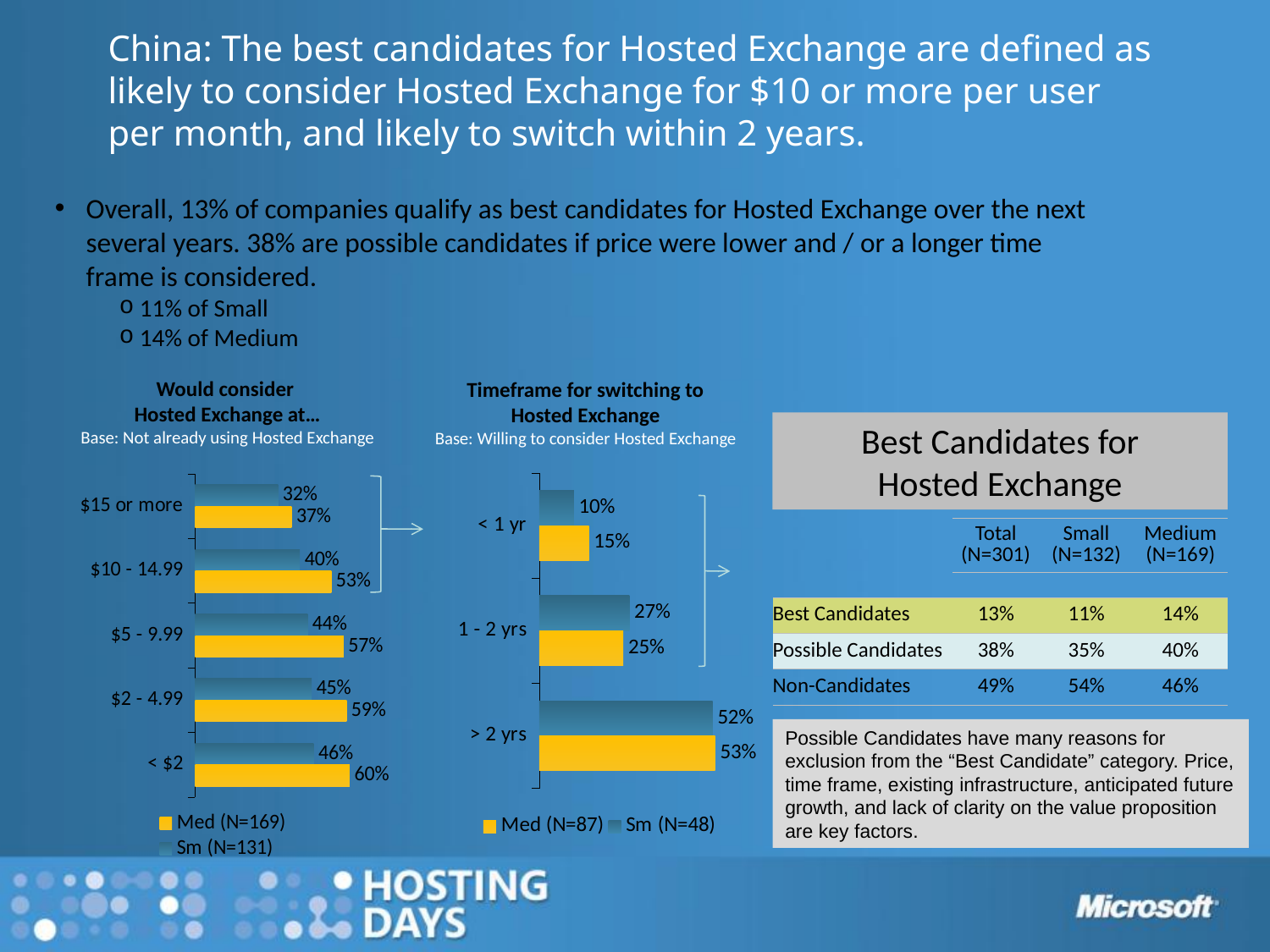
In the "Would consider Hosted Exchange at..." chart, what is the value for Sm at $15 or more? 32% In the "Would consider Hosted Exchange at..." chart, what is the value for Med at $10 - 14.99? 53% In the "Timeframe for switching to Hosted Exchange" chart, which is larger at 1 - 2 yrs: the Sm value or the Med value? Sm In the "Would consider Hosted Exchange at..." chart, which price category has the highest Med value? < $2 In the "Timeframe for switching to Hosted Exchange" chart, what is the value for Sm at > 2 yrs? 52% How many series does the legend of the "Timeframe for switching to Hosted Exchange" chart list? 2 In the "Timeframe for switching to Hosted Exchange" chart, which timeframe has the lowest Sm value? < 1 yr What kind of chart is the "Would consider Hosted Exchange at..." chart? bar chart In the "Would consider Hosted Exchange at..." chart, do the Sm values rise or fall as the price category moves from $15 or more down to < $2? rise In the "Would consider Hosted Exchange at..." chart, how many price categories are shown? 5 In the "Would consider Hosted Exchange at..." chart, what is the difference between the Med and Sm values at $5 - 9.99? 13% In the "Timeframe for switching to Hosted Exchange" chart, what is the value for Med at < 1 yr? 15%